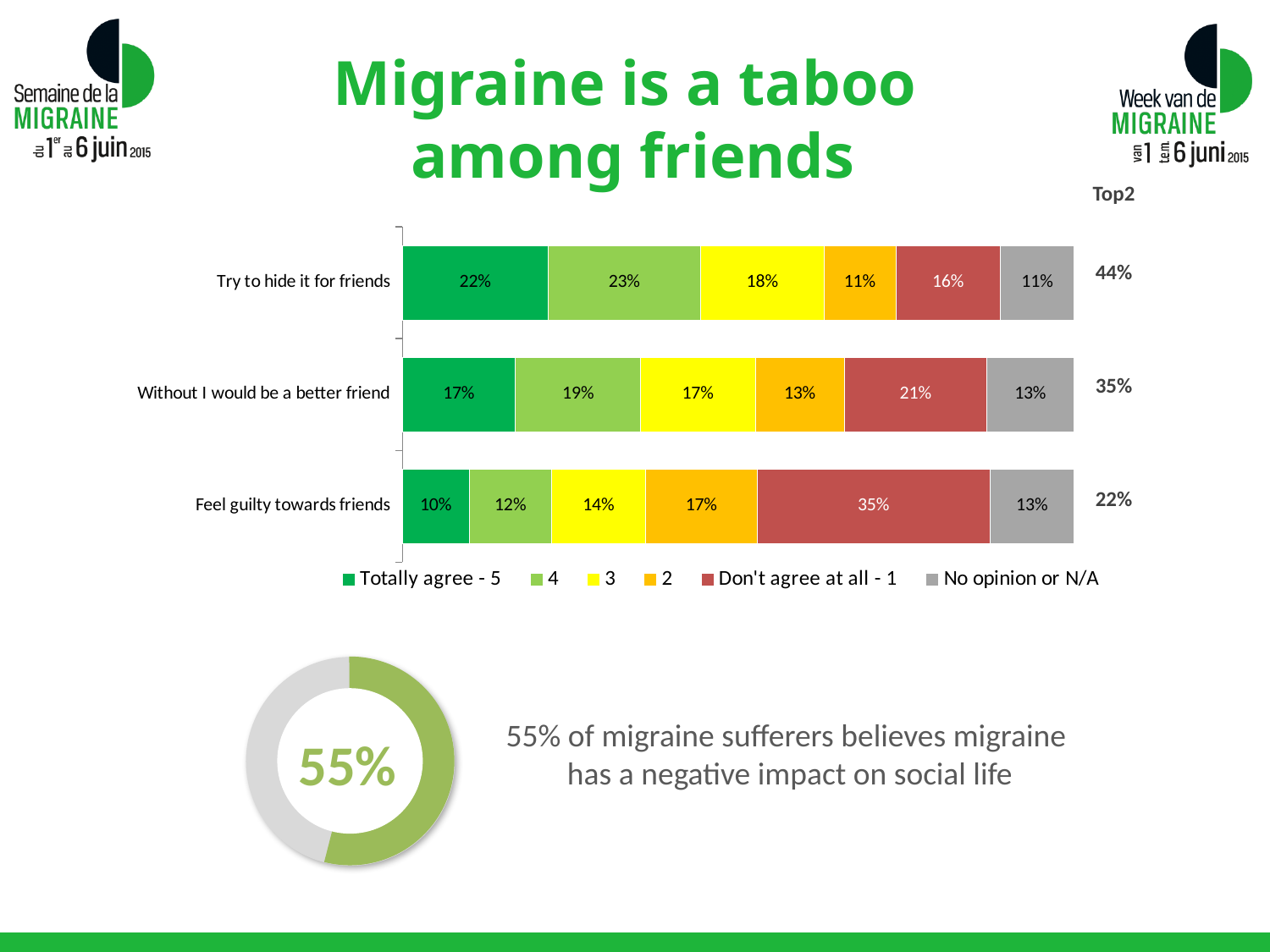
How many series does the legend of the stacked bar chart list? 6 What value is shown in the centre of the doughnut chart at the bottom of the slide? 55% In the stacked bar chart, what percentage of respondents chose 'Totally agree - 5' for 'Try to hide it for friends'? 22% In the stacked bar chart, which has a larger 'Don't agree at all - 1' share: 'Try to hide it for friends' or 'Without I would be a better friend'? Without I would be a better friend In the stacked bar chart, what percentage chose 'Don't agree at all - 1' for 'Feel guilty towards friends'? 35% In the stacked bar chart, what is the Top2 value shown for 'Try to hide it for friends'? 44% In the stacked bar chart, which statement has the highest 'Don't agree at all - 1' percentage? Feel guilty towards friends In the stacked bar chart, what is the difference between the 'Totally agree - 5' values for 'Try to hide it for friends' and 'Feel guilty towards friends'? 12% In the stacked bar chart, what is the value of the '4' segment for 'Without I would be a better friend'? 19% In the stacked bar chart, which statement has the lowest 'Totally agree - 5' percentage? Feel guilty towards friends What type of chart is the top chart on the slide? Stacked bar chart How many statements (categories) are shown in the stacked bar chart? 3